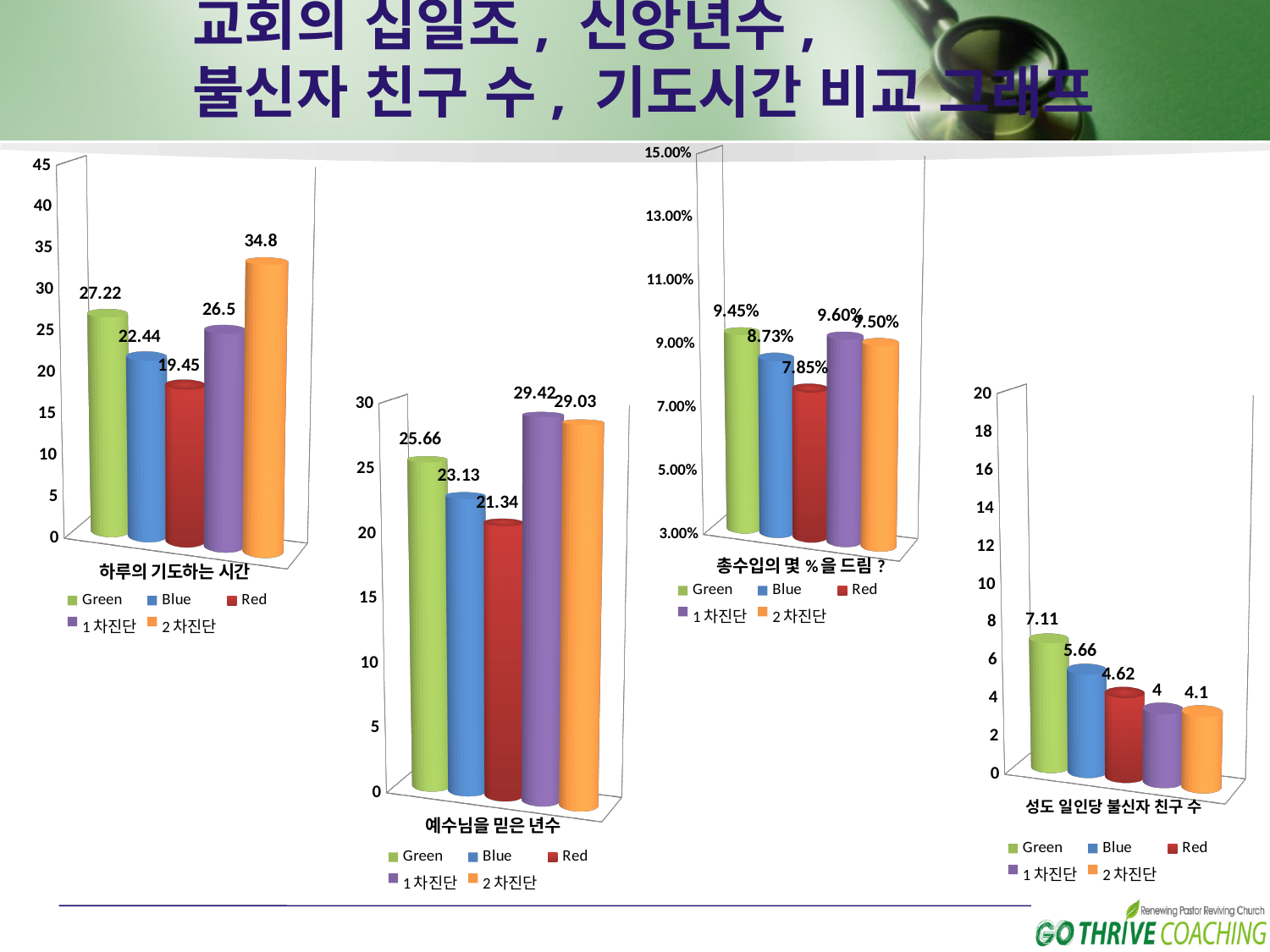
In the chart titled 총수입의 몇 %을 드림?, what is the value for Blue? 8.73% How many series does the legend of the chart titled 성도 일인당 불신자 친구 수 list? 5 In the chart titled 성도 일인당 불신자 친구 수, what is the value for Green? 7.11 In the chart titled 예수님을 믿은 년수, which series has the highest value? 1차진단 What kind of chart is the chart titled 하루의 기도하는 시간? bar chart In the chart titled 하루의 기도하는 시간, what is the difference between the Green value and the Blue value? 4.78 In the chart titled 성도 일인당 불신자 친구 수, what is the difference between the Blue value and the Red value? 1.04 In the chart titled 예수님을 믿은 년수, what is the value for Red? 21.34 In the chart titled 총수입의 몇 %을 드림?, which series has the lowest value? Red In the chart titled 하루의 기도하는 시간, which series has the lowest value? Red In the chart titled 하루의 기도하는 시간, what is the value for 2차진단? 34.8 In the chart titled 예수님을 믿은 년수, is the value for Green larger or smaller than the value for Blue? larger